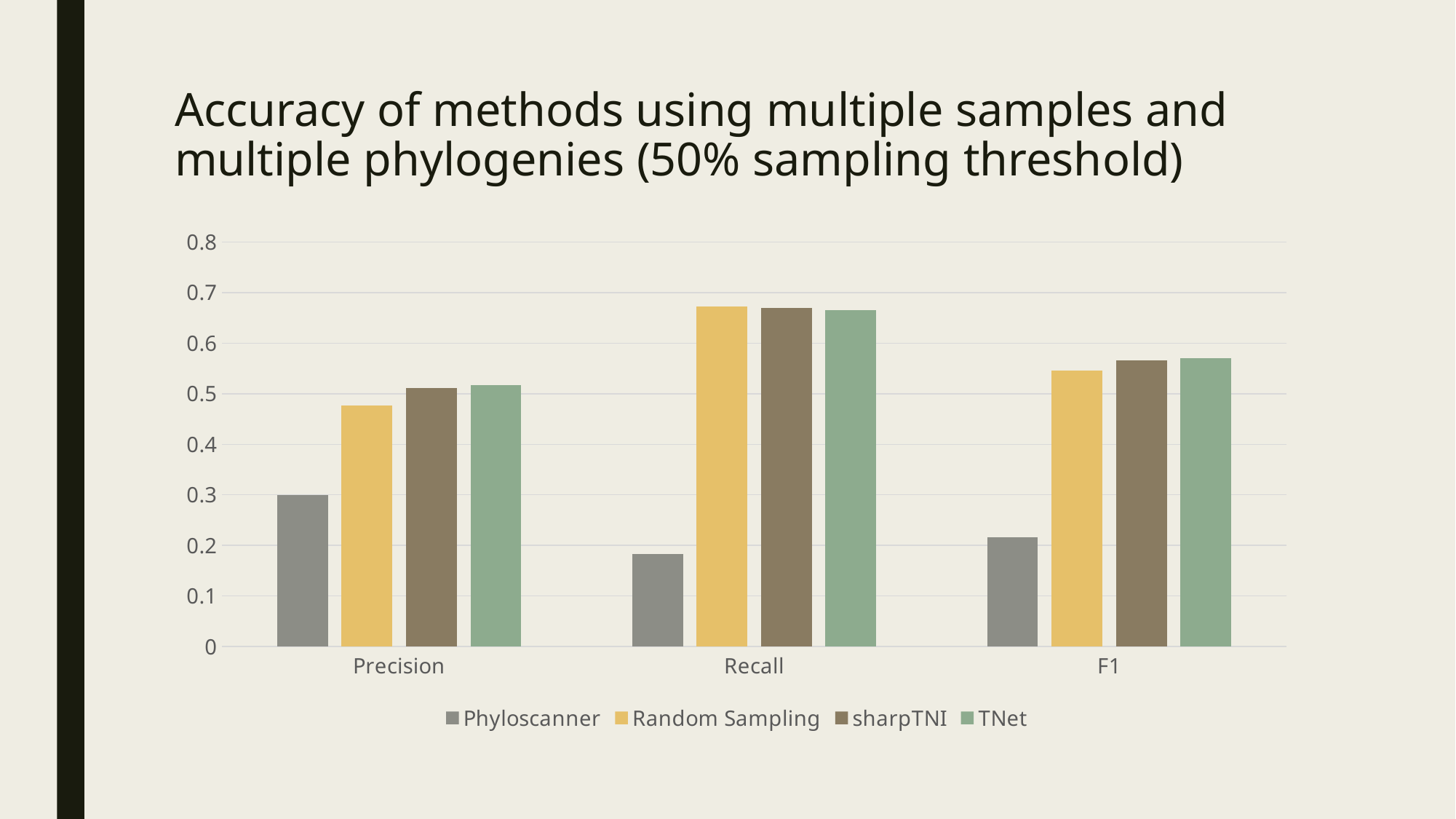
Is the Precision value for Random Sampling greater or less than 0.5? less Is the Recall value for Phyloscanner greater or less than 0.2? less Which is larger for Random Sampling: its Precision or its Recall? Recall How many categories are shown on the x axis? 3 How many series does the legend list? 4 Which series is shown in yellow in the legend? Random Sampling Which is larger for Phyloscanner: its Precision or its Recall? Precision What kind of chart is shown on the slide? Bar chart Is the Recall value for Random Sampling greater or less than 0.6? greater Which method has the lowest F1? Phyloscanner Which method has the lowest Recall? Phyloscanner